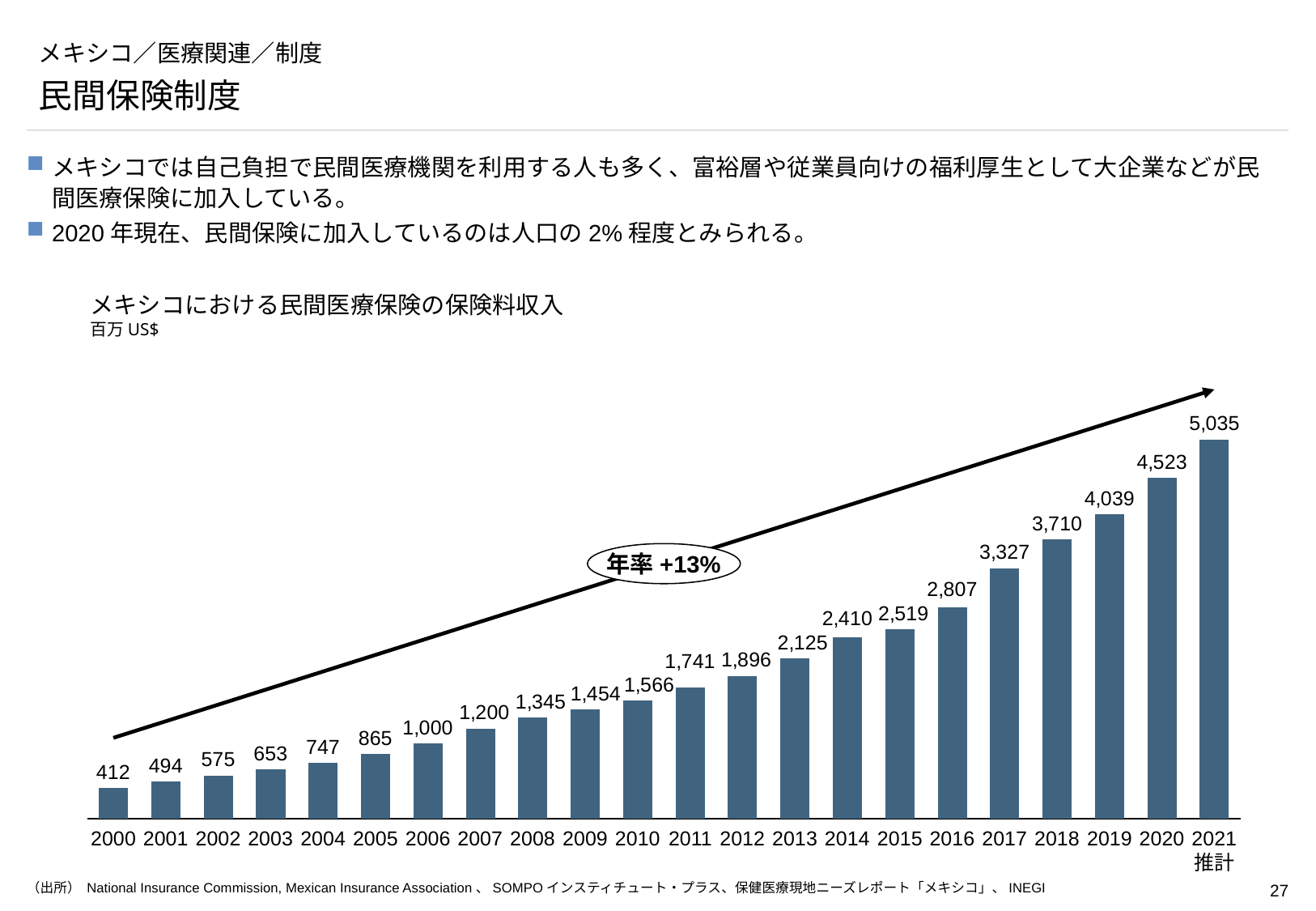
What is the difference between the values for 2020 and 2000? 4,111 What is the value for 2017 in the chart? 3,327 Which is larger, the value for 2014 or the value for 2015? 2015 What kind of chart is shown on the slide? Bar chart What annual growth rate is written in the oval label on the chart? 年率 +13% What is the value for 2000 in the chart? 412 What is the difference between the values for 2021 推計 and 2020? 512 What is the value for 2010 in the chart? 1,566 Which year has the lowest value in the chart? 2000 How many bars are plotted in the chart? 22 Which year has the highest value in the chart? 2021 推計 Do the values rise or fall from 2000 to 2021 推計? Rise